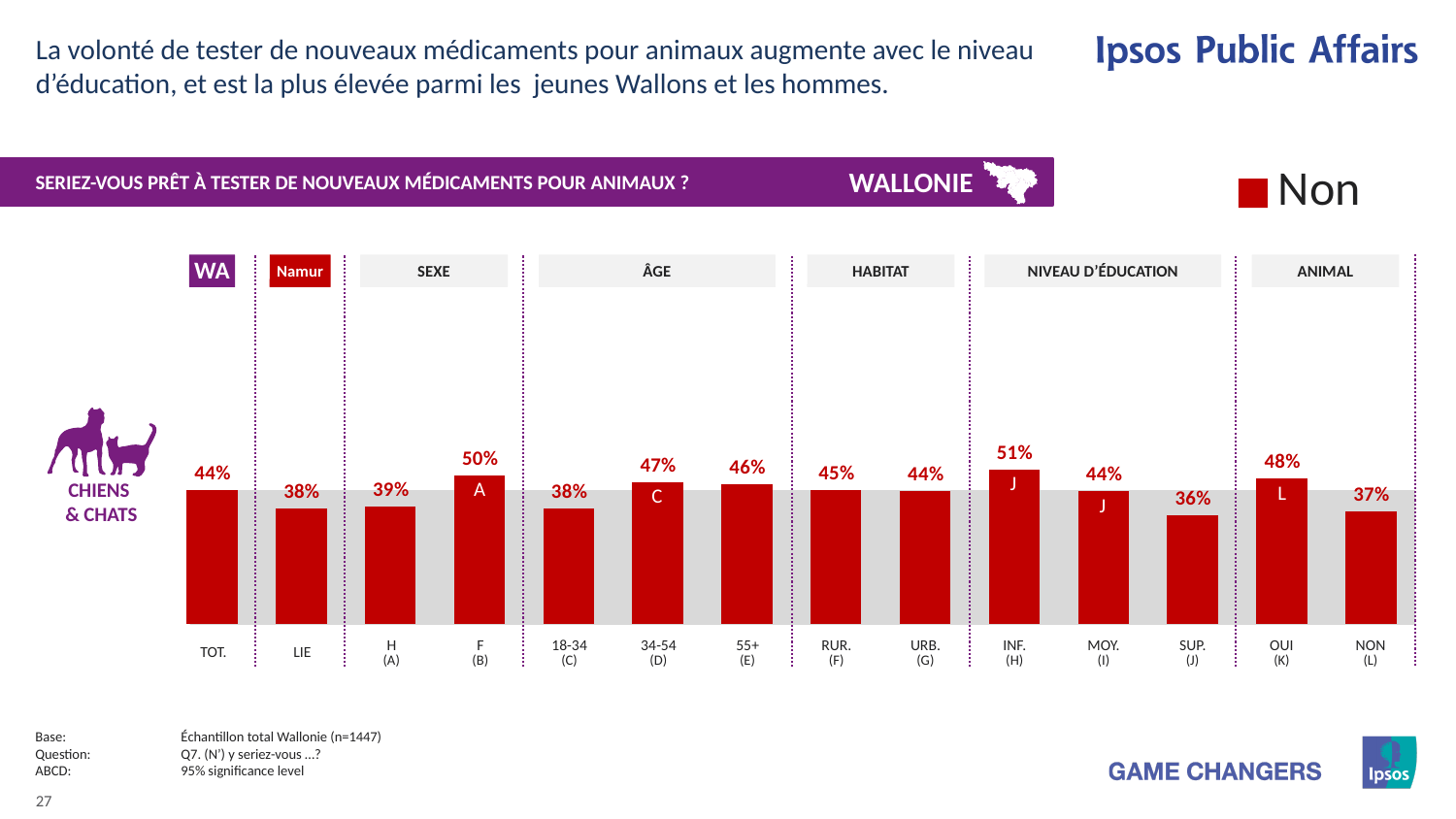
What is the value shown for TOT. (the WA total)? 44% What is the difference between the values for F (B) and H (A)? 11% Which category has the lowest value on the chart? SUP. (J) What is the difference between the values for INF. (H) and SUP. (J)? 15% What entry does the legend show for the red bars? Non What is the value shown for F (B) in the SEXE group? 50% What is the value shown for SUP. (J) under NIVEAU D'ÉDUCATION? 36% What type of chart is shown on the slide? Bar chart How many bars are plotted on the chart? 14 Which is larger, the value for OUI (K) or the value for NON (L)? OUI (K) What is the value shown for the 18-34 (C) age group? 38% Which category has the highest value on the chart? INF. (H)